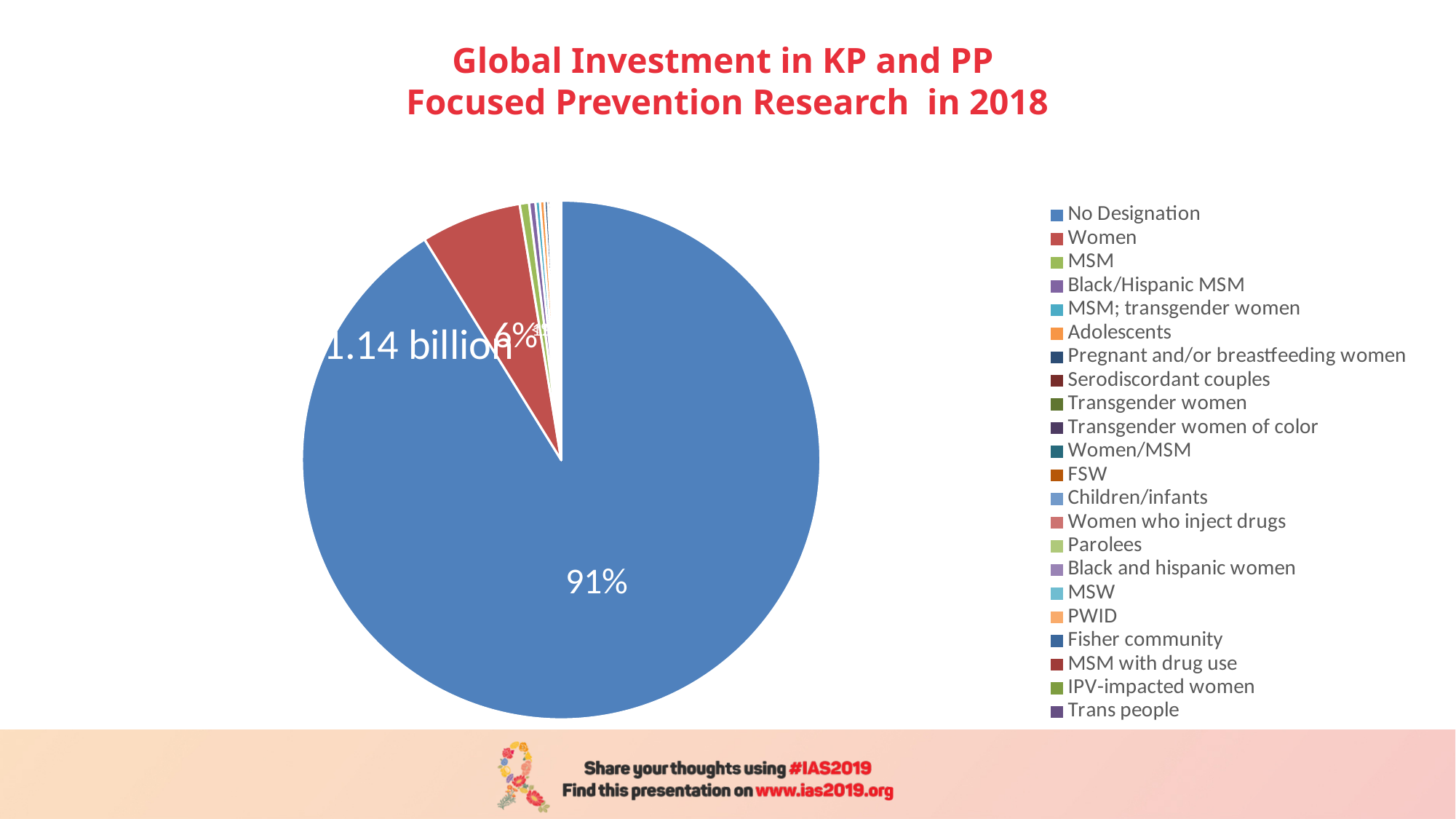
Which category has the largest slice of the pie? No Designation What is the difference in percentage points between the No Designation share and the Women share? 85% What amount is written on the largest slice of the pie? 1.14 billion What share of the pie does the Women slice represent? 6% What type of chart is shown on the slide? pie chart What is the title of the chart? Global Investment in KP and PP Focused Prevention Research in 2018 What colour is the No Designation slice? blue Is the share for No Designation greater or less than 50%? greater How many categories are listed in the legend? 22 Is the share for Women greater or less than 10%? less What share of the pie does the No Designation slice represent? 91% Which slice is larger, No Designation or Women? No Designation